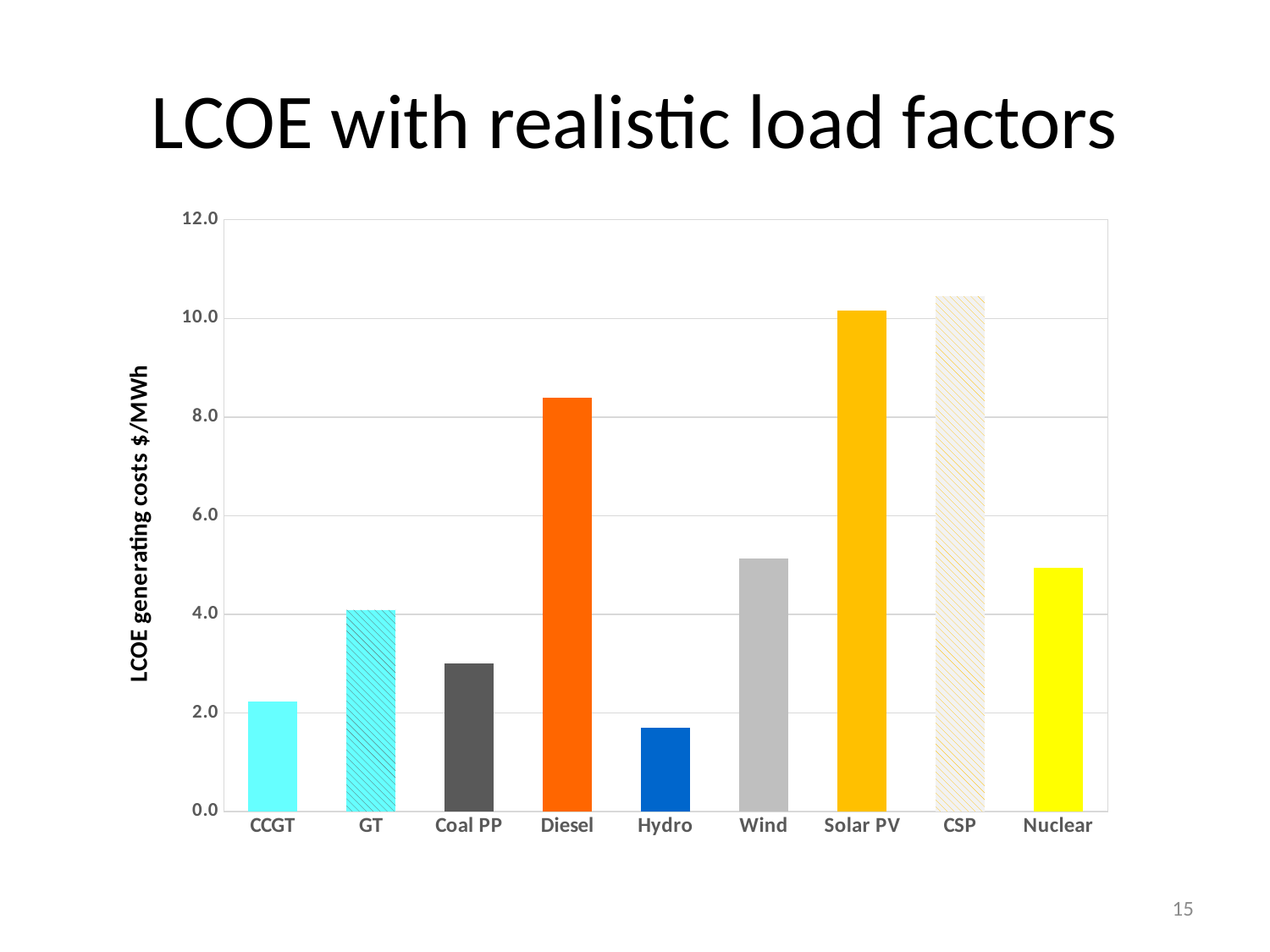
How many categories are plotted on the x axis of the chart? 9 Is the value for Wind greater or less than 6.0? less Which has the higher LCOE generating cost, Diesel or Wind? Diesel What is the title of the slide containing the chart? LCOE with realistic load factors Is the value for Nuclear greater or less than 4.0? greater Is the value for Hydro greater or less than 2.0? less What is the label on the vertical axis of the chart? LCOE generating costs $/MWh Which category has the lowest LCOE generating cost in the chart? Hydro What kind of chart is shown on the slide? bar chart Which has the higher LCOE generating cost, GT or Coal PP? GT